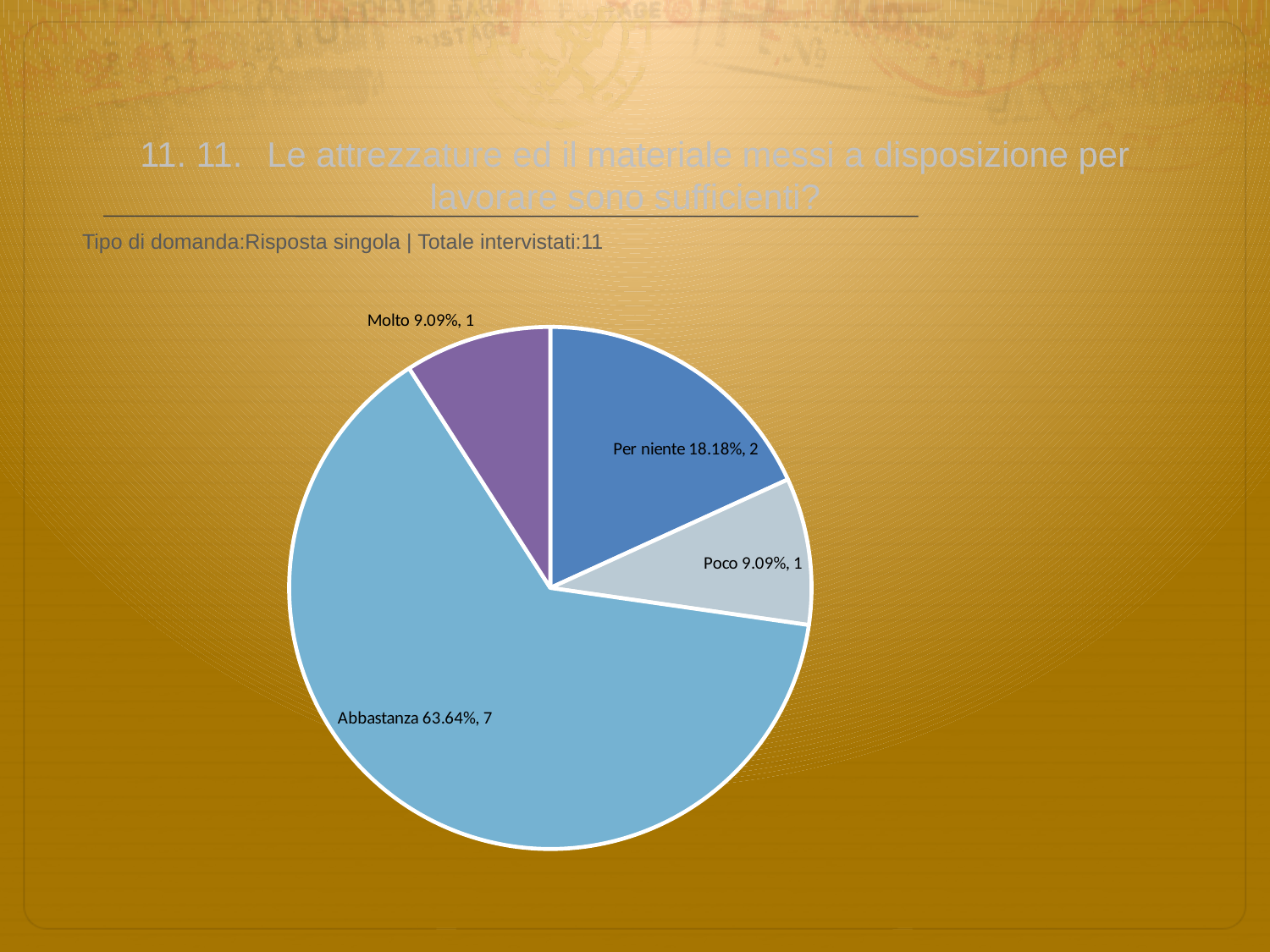
Which is larger, the Per niente slice or the Poco slice? Per niente Which category has the largest slice of the pie? Abbastanza What percentage share does the Abbastanza slice have? 63.64% How many respondents answered Per niente? 2 What is the difference in respondent count between Abbastanza and Per niente? 5 What percentage share does the Per niente slice have? 18.18% What kind of chart is shown on the slide? pie chart What is the total number of respondents shown on the slide? 11 How many respondents answered Poco? 1 What percentage share does the Molto slice have? 9.09% How many slices does the pie chart have? 4 How many respondents answered Abbastanza? 7